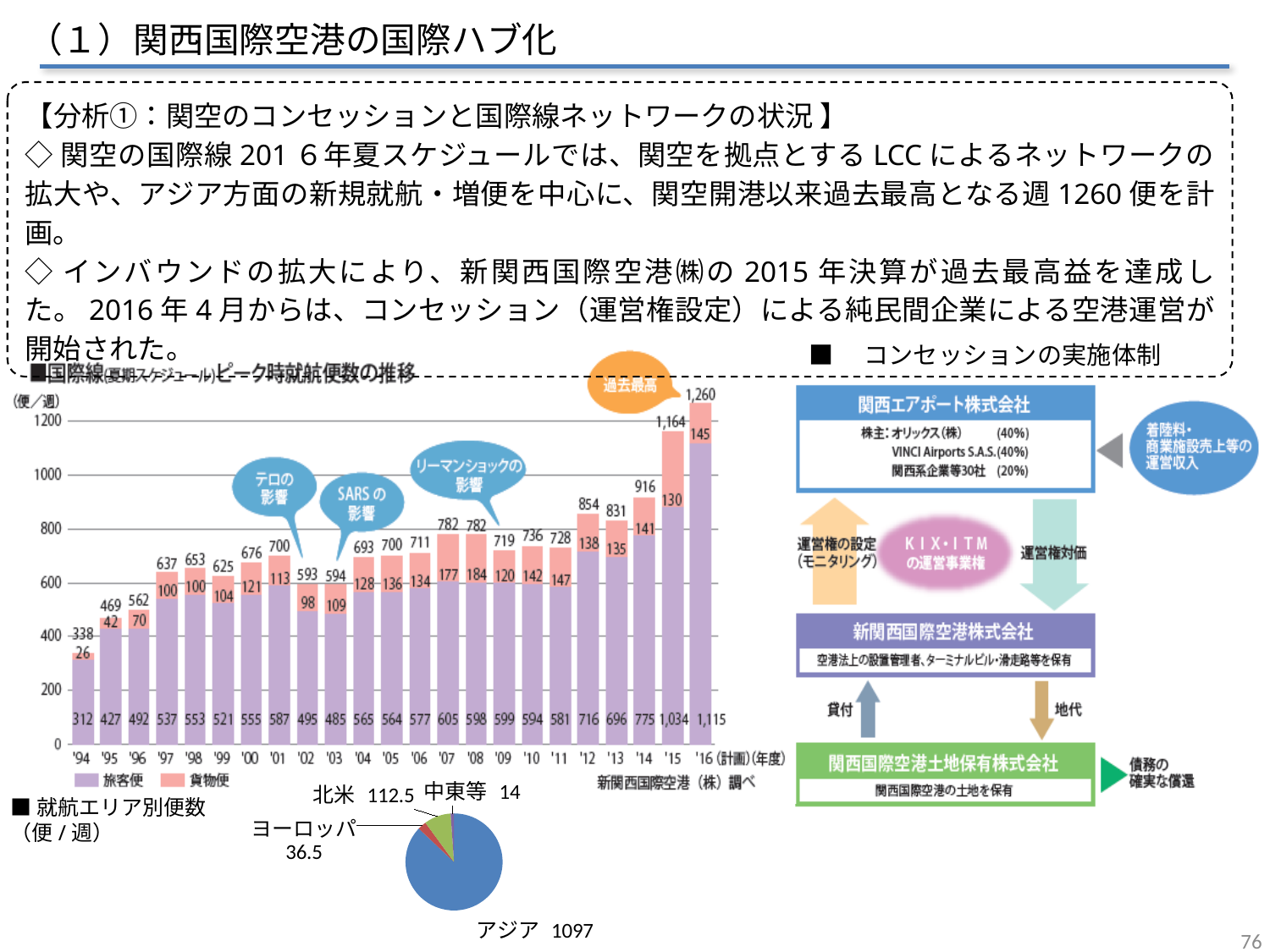
In the bar chart of international flights per week, how many series does the legend list? 2 In the bar chart of international flights per week (国際線ピーク時就航便数の推移), what is the total value for '16 (計画)? 1,260 In the 就航エリア別便数 pie chart, what is the value for 北米? 112.5 In the bar chart of international flights per week, which year has the highest total? '16 (計画) In the bar chart of international flights per week, is the total for '02 larger or smaller than the total for '01? smaller In the bar chart of international flights per week, what is the difference between the totals for '15 and '14? 248 In the bar chart of international flights per week, what is the 貨物便 (cargo) value for '08? 184 In the bar chart of international flights per week, how many years are shown on the x axis? 23 In the 就航エリア別便数 pie chart, which area has the largest slice? アジア In the bar chart of international flights per week, what is the 旅客便 (passenger) value for '15? 1,034 In the bar chart of international flights per week, which year has the lowest total? '94 What type of chart is the 就航エリア別便数 chart at the bottom of the slide? pie chart